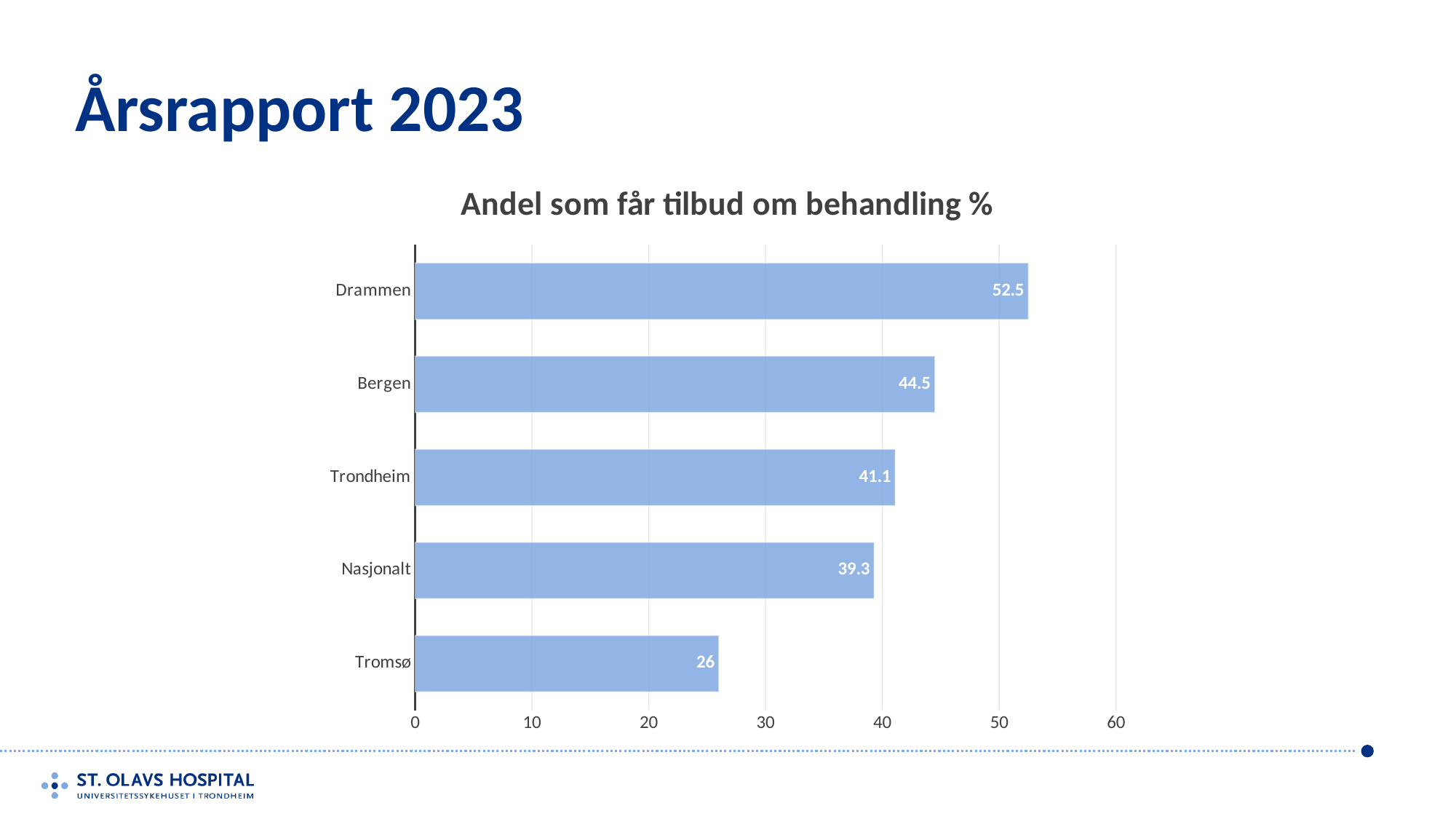
What is the difference between the values for Drammen and Tromsø? 26.5 What is the difference between the values for Bergen and Nasjonalt? 5.2 Is the value for Tromsø greater or less than 30? less Which category has the highest value? Drammen What is the value for Drammen? 52.5 What is the value for Bergen? 44.5 How many categories are shown in the chart? 5 What kind of chart is shown on the slide? bar chart Which is larger, the value for Trondheim or the value for Nasjonalt? Trondheim What is the value for Tromsø? 26 What is the value for Trondheim? 41.1 Which category has the lowest value? Tromsø